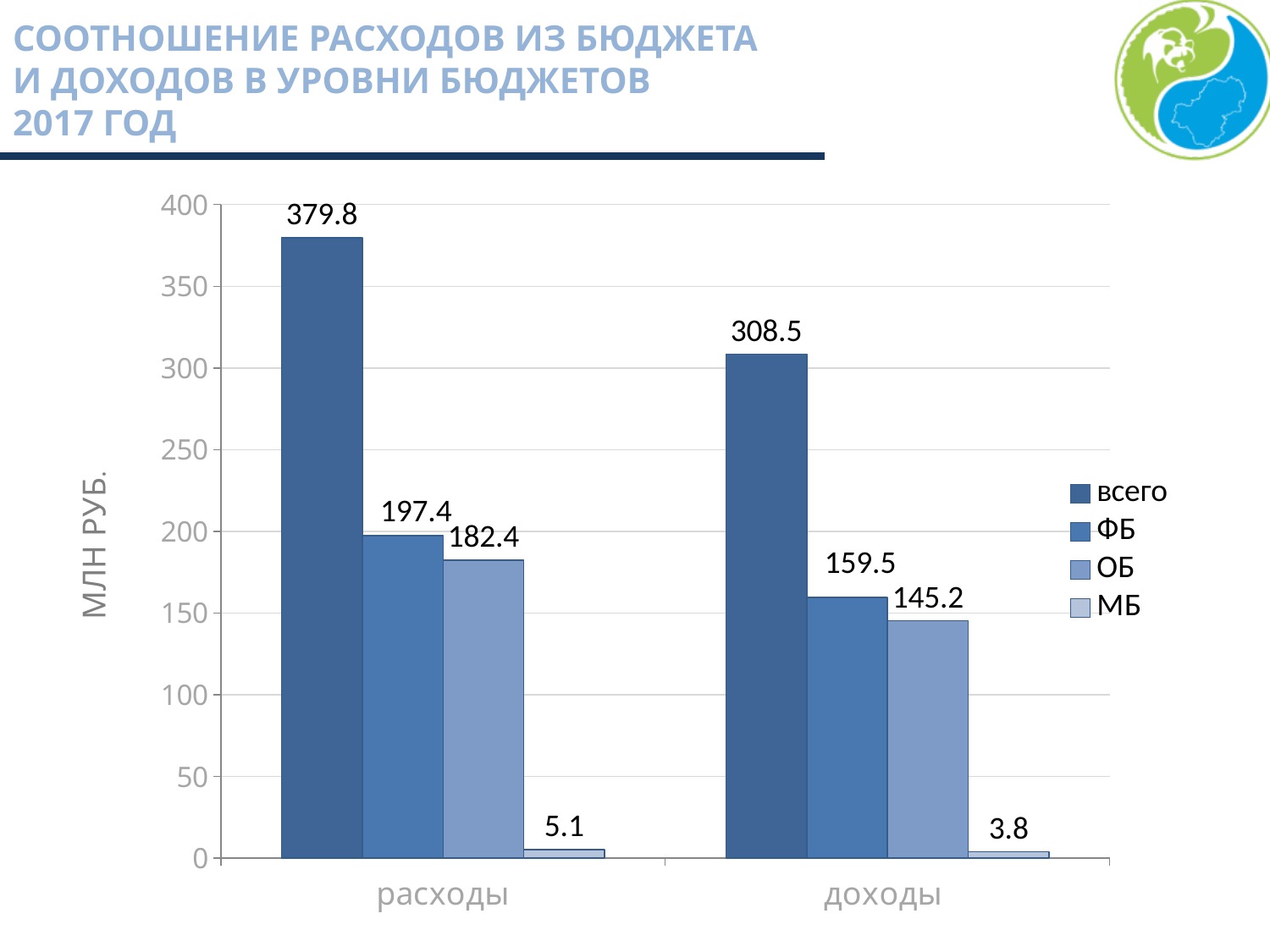
Which series has the highest value for 'расходы'? всего What is the label of the vertical axis? МЛН РУБ. How many categories are shown on the x axis? 2 What is the value of the 'ФБ' series for 'доходы'? 159.5 How many series does the legend list? 4 What kind of chart is shown on the slide? bar chart What is the value of the 'всего' series for 'расходы'? 379.8 What is the difference between the 'всего' values for 'расходы' and 'доходы'? 71.3 What is the value of the 'МБ' series for 'расходы'? 5.1 Which series has the lowest value for 'доходы'? МБ Which is larger: the 'ОБ' value for 'расходы' or the 'ОБ' value for 'доходы'? расходы What is the value of the 'ОБ' series for 'доходы'? 145.2